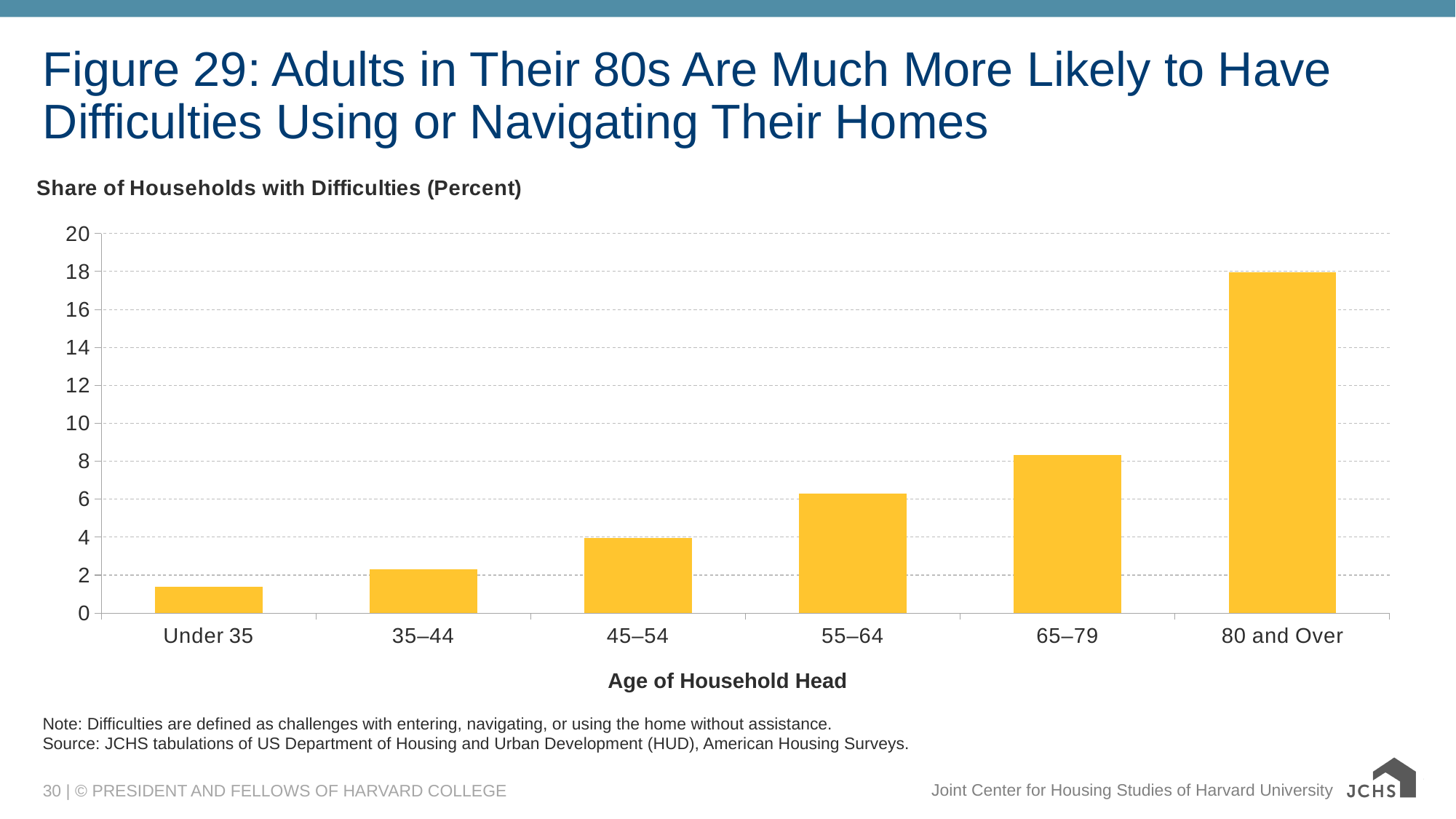
What kind of chart is shown on the slide? bar chart Do the values rise or fall as age of household head increases along the x axis? rise Which age group has the lowest share of households with difficulties? Under 35 What is the maximum value shown on the y axis? 20 Is the value for 80 and Over greater or less than 16? greater What is the label of the x axis? Age of Household Head Is the value for 65–79 greater or less than 10? less Which has a larger share of households with difficulties, 45–54 or 65–79? 65–79 Is the value for Under 35 greater or less than 2? less How many age categories are shown on the x axis? 6 Which age group has the highest share of households with difficulties? 80 and Over